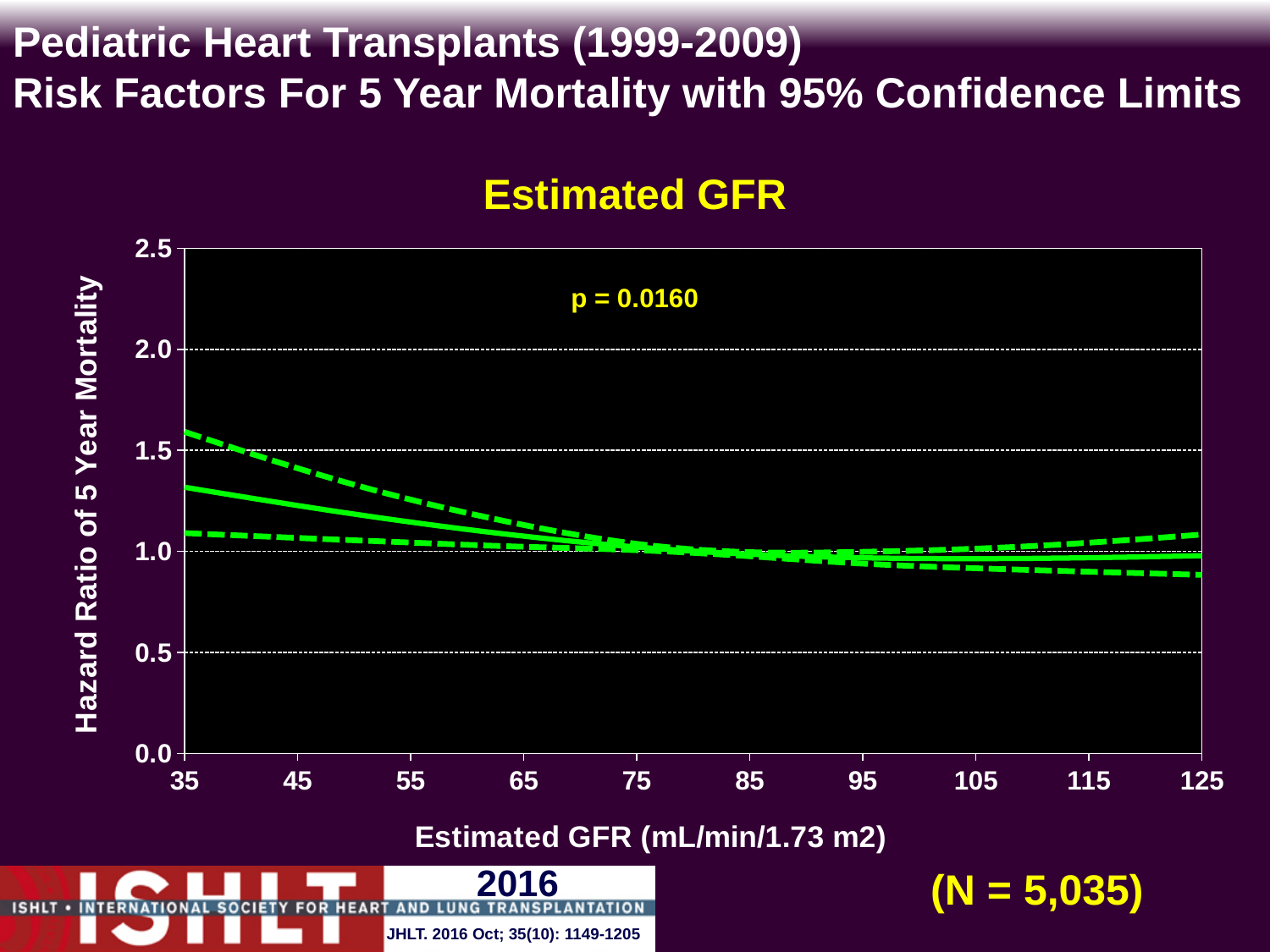
Does the solid hazard ratio line rise or fall as estimated GFR increases from 35 to 125? falls Is the value of the solid hazard ratio line at an estimated GFR of 35 greater or less than 1.0? greater Is the value of the solid hazard ratio line at an estimated GFR of 125 greater or less than 1.5? less Is the value of the lower dashed confidence limit at an estimated GFR of 125 greater or less than 1.0? less What kind of chart is shown on the slide? line chart How many lines are plotted on the chart? 3 Is the solid hazard ratio line higher at an estimated GFR of 35 or at 125? 35 What is the title of the chart? Estimated GFR What p-value is printed on the chart? p = 0.0160 What is the N (sample size) shown on the slide? (N = 5,035)